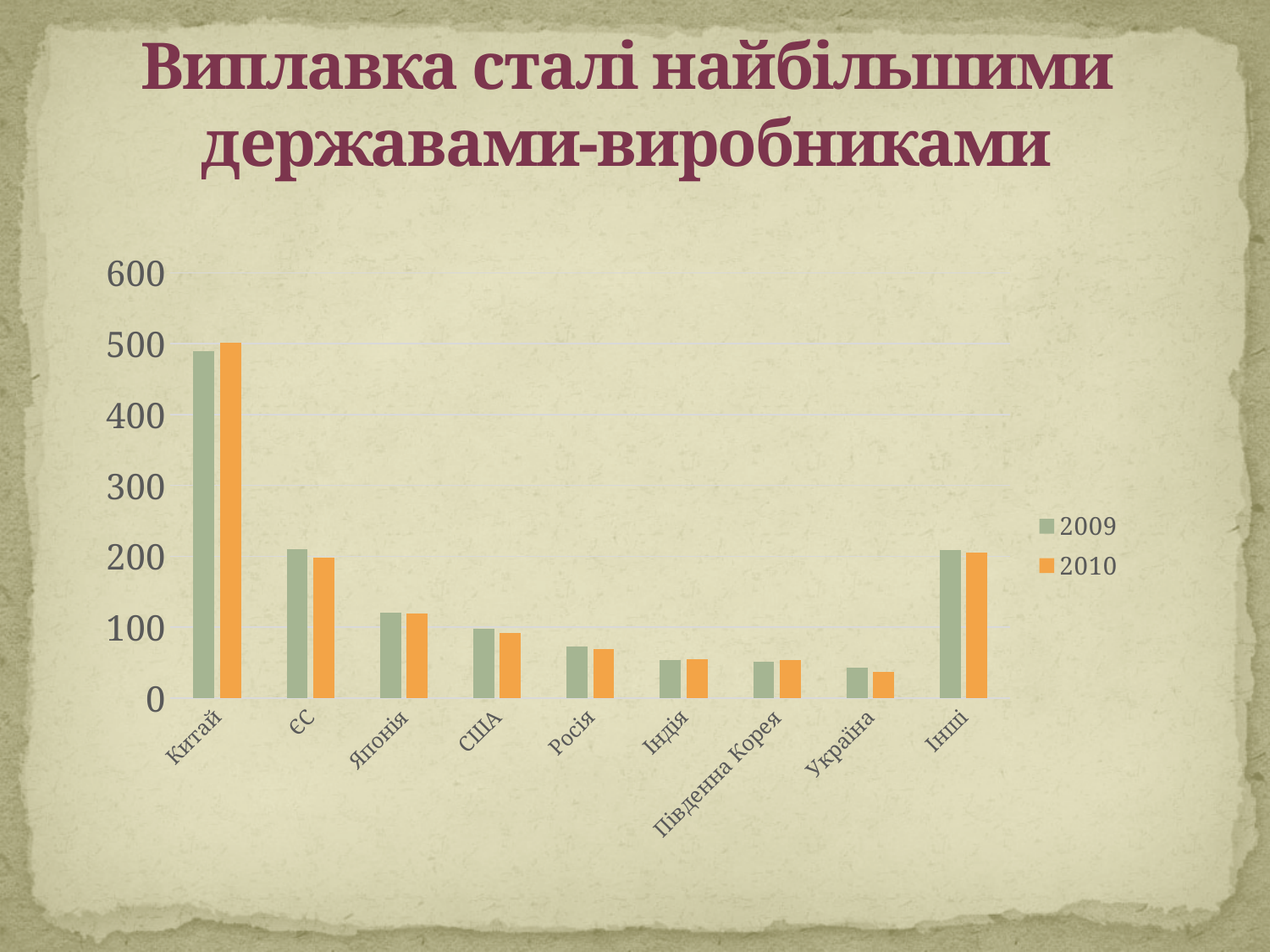
Is the value for Україна in 2010 greater or less than 100? less Is the value for Китай in 2009 greater or less than 400? greater Is the value for ЄС in 2010 greater or less than 300? less How many series does the legend list? 2 Which is larger: the 2009 value for Китай or the 2009 value for ЄС? Китай Which category has the lowest value for 2009? Україна What kind of chart is shown on the slide? bar chart Which is larger: the 2010 value for Японія or the 2010 value for Росія? Японія Which series is shown in orange in the legend? 2010 How many categories are shown on the x axis of the chart? 9 Which category has the highest value for 2010? Китай Which category has the lowest value for 2010? Україна